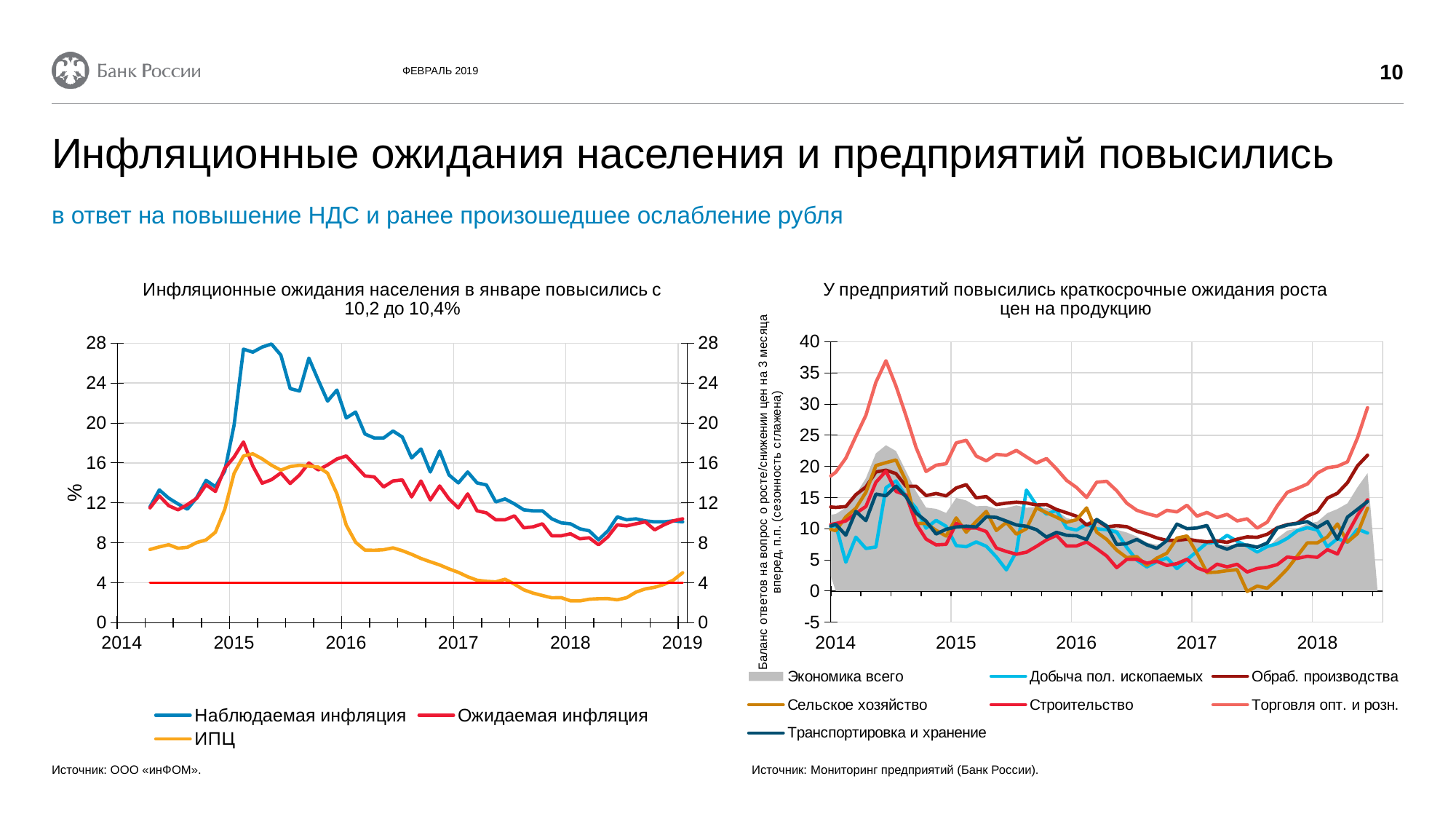
How many series does the legend of the right chart, 'У предприятий повысились краткосрочные ожидания роста цен на продукцию', list? 7 On the left chart, at the start of 2019, which is higher: Наблюдаемая инфляция or ИПЦ? Наблюдаемая инфляция On the right chart, is the 2014 peak of Торговля опт. и розн. greater or less than 35? greater On the left chart, which series reaches the highest value? Наблюдаемая инфляция On the right chart, does Торговля опт. и розн. rise or fall over the course of 2018? rise On the left chart, does ИПЦ rise or fall between 2016 and 2018? fall On the right chart, which series reaches the highest value? Торговля опт. и розн. On the left chart, is the 2015 peak of Наблюдаемая инфляция greater or less than 24? greater On the left chart, is the value of ИПЦ at the start of 2018 greater or less than 4? less What kind of chart is the left chart, 'Инфляционные ожидания населения в январе повысились с 10,2 до 10,4%'? line chart How many series does the legend of the left chart list? 3 According to the title of the left chart, to what level did household inflation expectations rise in January? 10,4%